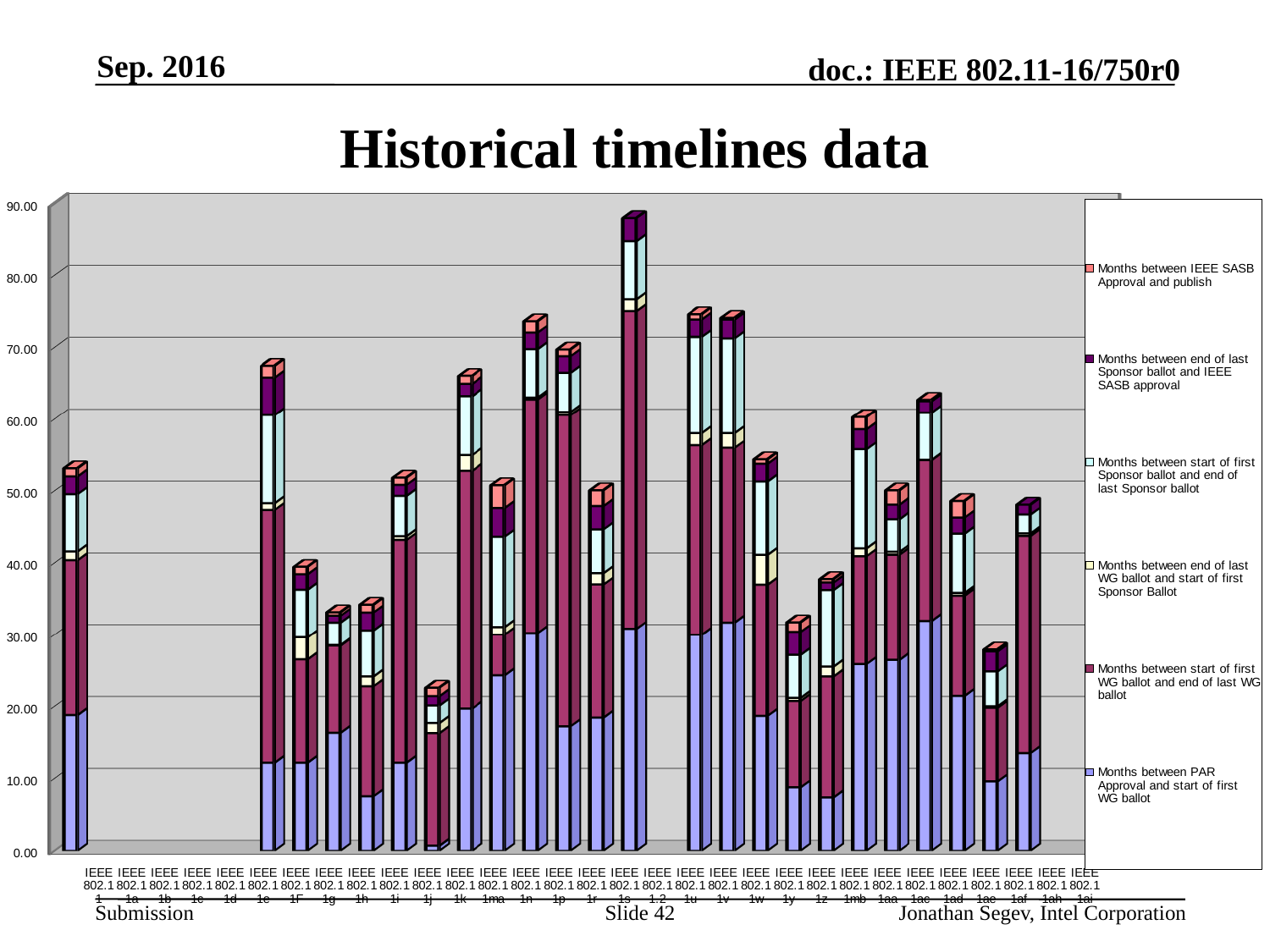
What is the title of the chart? Historical timelines data What kind of chart is shown on the slide? Stacked bar chart Is the total of the tallest stacked bar greater or less than 80? greater Is the total of the shortest stacked bar greater or less than 20? greater Which series is listed at the bottom of the legend? Months between PAR Approval and start of first WG ballot What is the highest tick value shown on the vertical axis? 90.00 Is the total of the shortest stacked bar greater or less than 30? less How many series does the legend list? 6